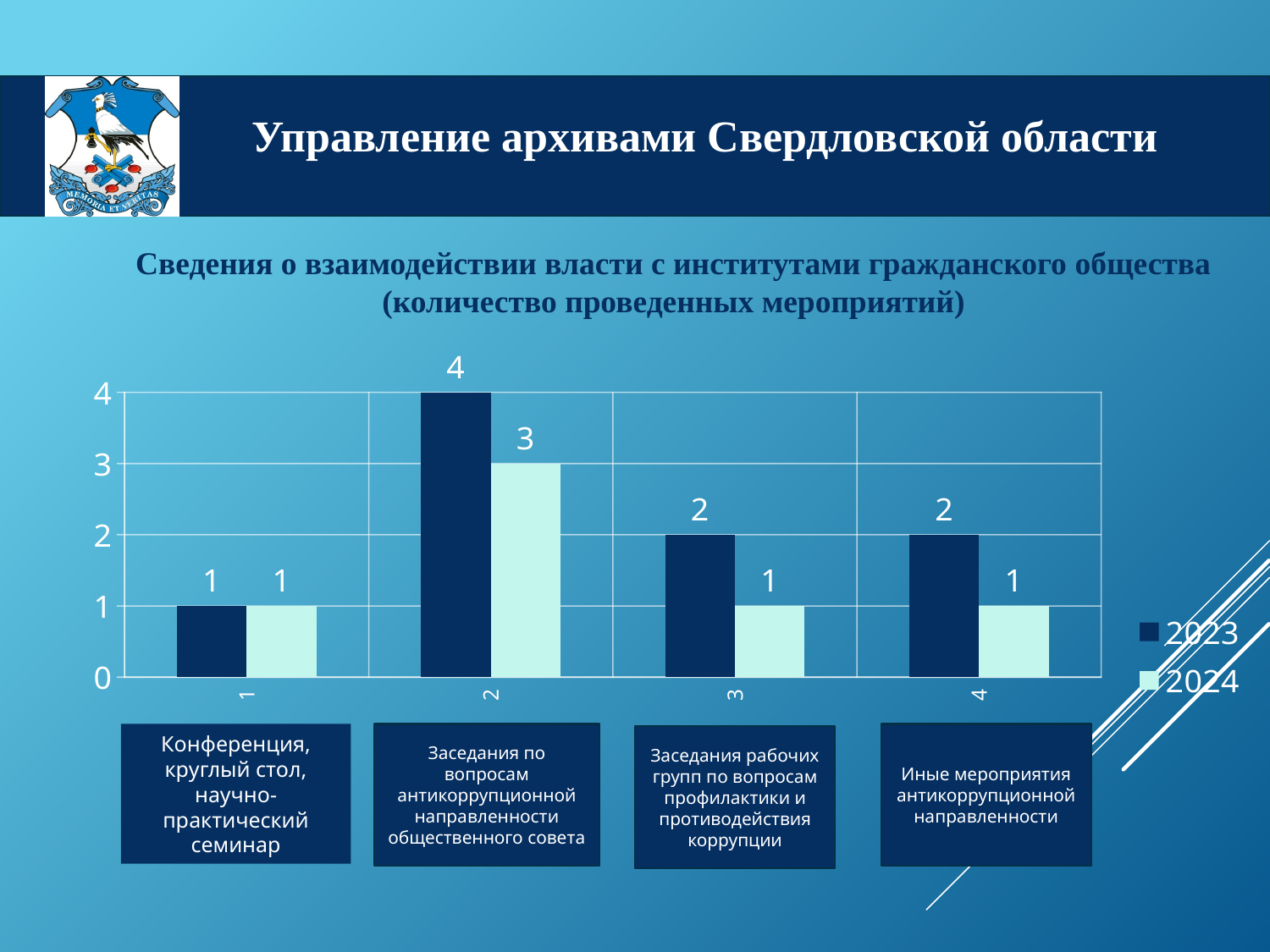
What is the difference between the 2023 and 2024 values in category 3? 1 How many series does the legend list? 2 How many categories are shown on the x axis of the chart? 4 What is the value for 2023 in category 3 (Заседания рабочих групп по вопросам профилактики и противодействия коррупции)? 2 Which category has the lowest value for 2023? 1 (Конференция, круглый стол, научно-практический семинар) What is the value for 2024 in category 2 (Заседания по вопросам антикоррупционной направленности общественного совета)? 3 Which series is shown in dark blue in the legend? 2023 Which category has the highest value for 2023? 2 (Заседания по вопросам антикоррупционной направленности общественного совета) In category 2, which series has the larger value, 2023 or 2024? 2023 What type of chart is shown on the slide? bar chart What is the value for 2023 in category 2 (Заседания по вопросам антикоррупционной направленности общественного совета)? 4 What is the value for 2024 in category 4 (Иные мероприятия антикоррупционной направленности)? 1